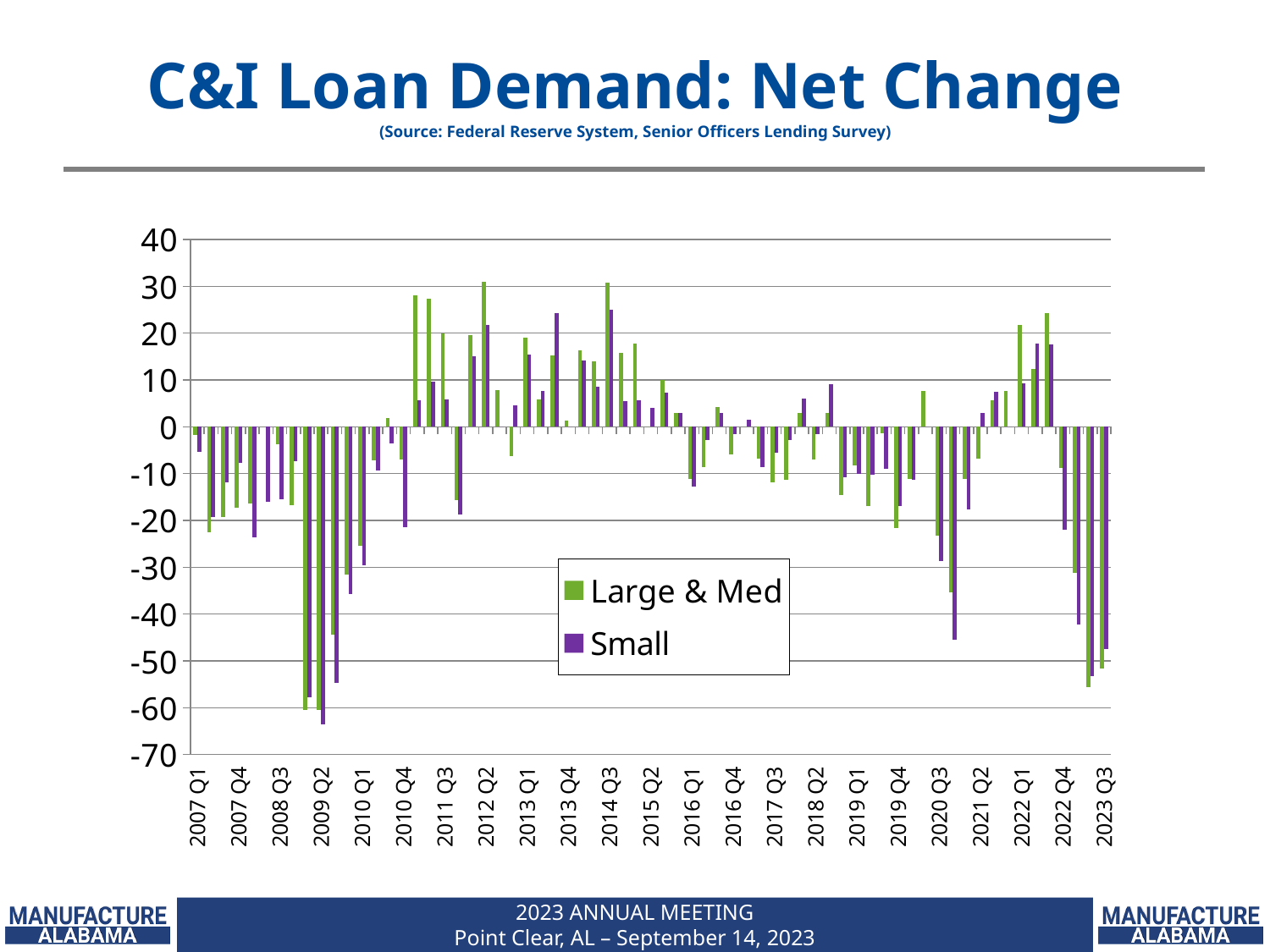
What is the title of the chart? C&I Loan Demand: Net Change How many series does the legend list? 2 Is the value for Large & Med in 2010 Q4 greater or less than 20? less In 2020 Q3, which series has the larger value, Large & Med or Small? Large & Med Is the value for Large & Med in 2022 Q4 greater or less than -20? greater What are the two series named in the legend? Large & Med and Small In 2010 Q4, which series has the larger value, Large & Med or Small? Large & Med Is the value for Small in 2023 Q3 greater or less than -30? less What kind of chart is shown on the slide? bar chart